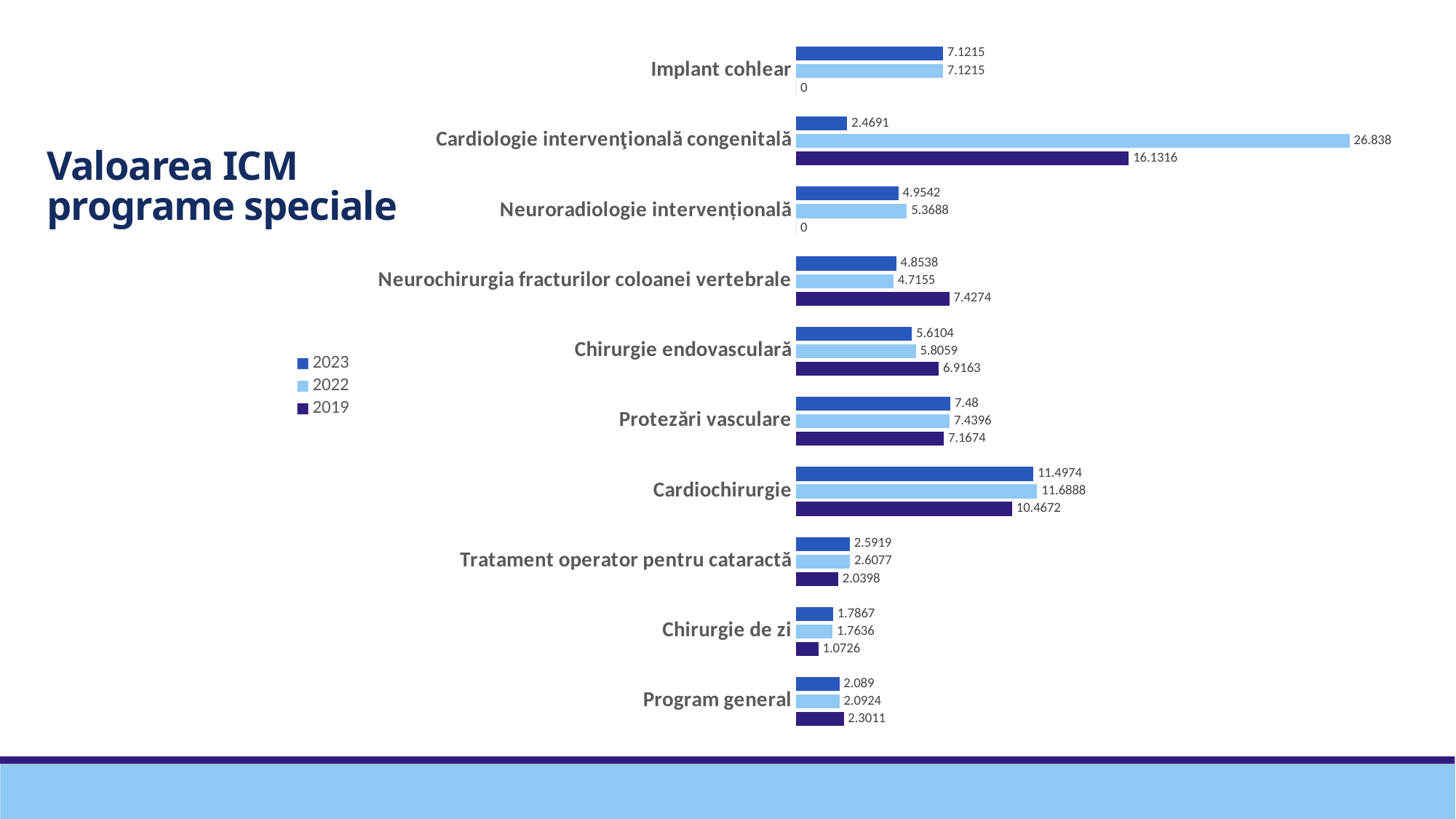
What is the difference between the 2022 and 2019 values for Cardiologie intervențională congenitală? 10.7064 What is the 2019 value for Cardiochirurgie? 10.4672 Which category has the highest 2022 value? Cardiologie intervențională congenitală What is the difference between the 2022 and 2023 values for Cardiochirurgie? 0.1914 What is the 2019 value for Implant cohlear? 0 Which category has the lowest 2023 value? Chirurgie de zi How many categories are shown in the chart? 10 How many series does the legend list? 3 For Protezări vasculare, which is larger: the 2023 value or the 2022 value? 2023 What kind of chart is shown on the slide? Bar chart What is the 2022 value for Cardiologie intervențională congenitală? 26.838 What is the title of the slide? Valoarea ICM programe speciale